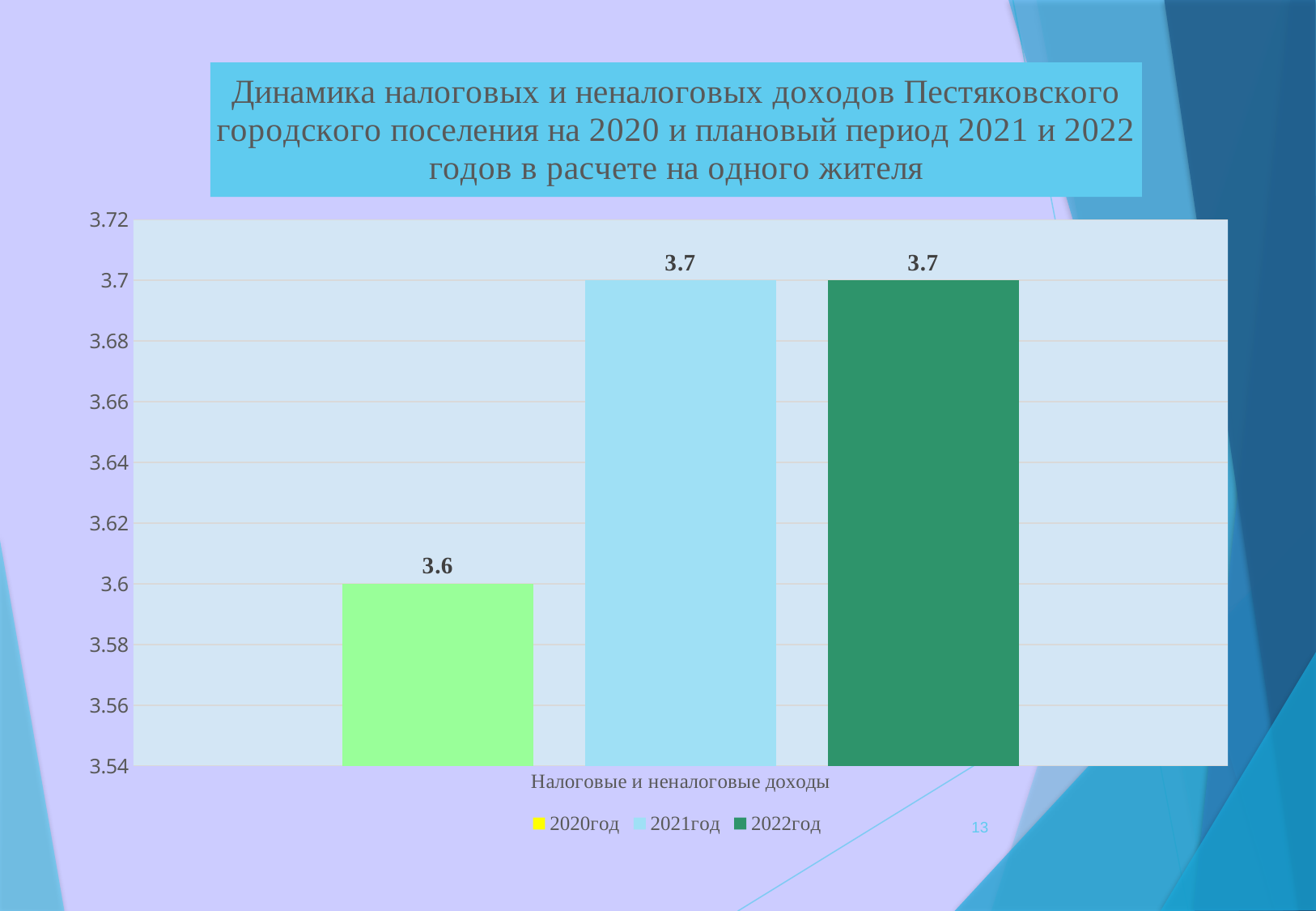
Is the value for 2021год greater or less than 3.68? greater Which year has the lowest value? 2020год Does the value rise or fall from 2020год to 2021год? rise What is the value for 2021год? 3.7 What kind of chart is shown on the slide? bar chart Which is larger, the value for 2020год or the value for 2022год? 2022год What is the value for 2020год? 3.6 Is the value for 2020год greater or less than 3.62? less What is the value for 2022год? 3.7 What is the difference between the values for 2021год and 2020год? 0.1 How many series does the legend list? 3 How many bars are plotted on the chart? 3